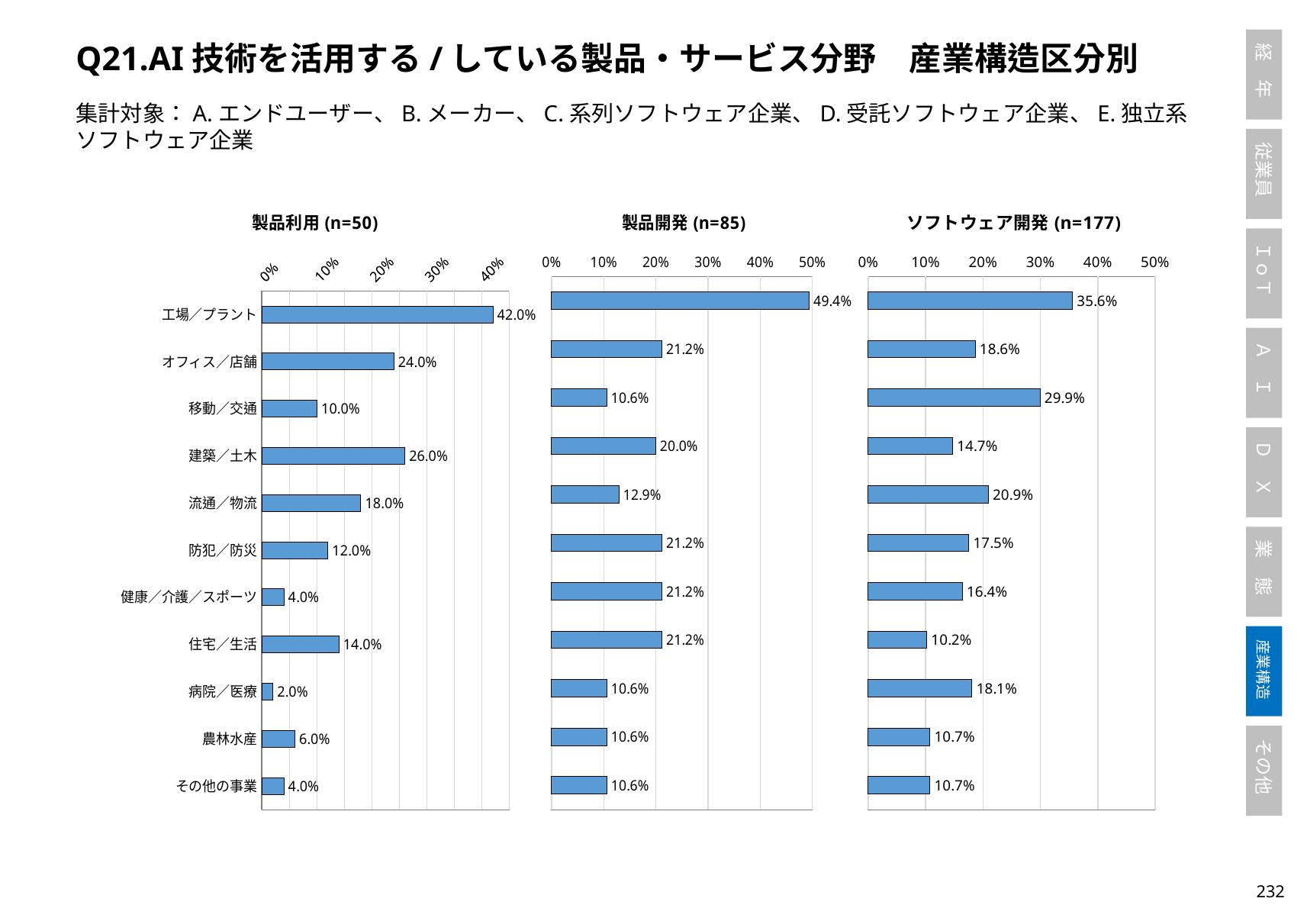
In the 製品開発 (n=85) chart, which category has the highest value? 工場／プラント In the 製品開発 (n=85) chart, what is the value for 建築／土木? 20.0% In the ソフトウェア開発 (n=177) chart, which category has the highest value? 工場／プラント In the ソフトウェア開発 (n=177) chart, what is the difference between 工場／プラント and オフィス／店舗? 17.0% In the 製品利用 (n=50) chart, what is the value for 工場／プラント? 42.0% In the 製品利用 (n=50) chart, which category has the lowest value? 病院／医療 In the 製品開発 (n=85) chart, which is larger, 流通／物流 or 防犯／防災? 防犯／防災 What is the title of the middle chart on the slide? 製品開発 (n=85) In the 製品利用 (n=50) chart, what is the difference between 建築／土木 and オフィス／店舗? 2.0% In the ソフトウェア開発 (n=177) chart, what is the value for 移動／交通? 29.9% How many categories are shown in the 製品利用 (n=50) chart? 11 What type of chart is the ソフトウェア開発 (n=177) chart? Bar chart